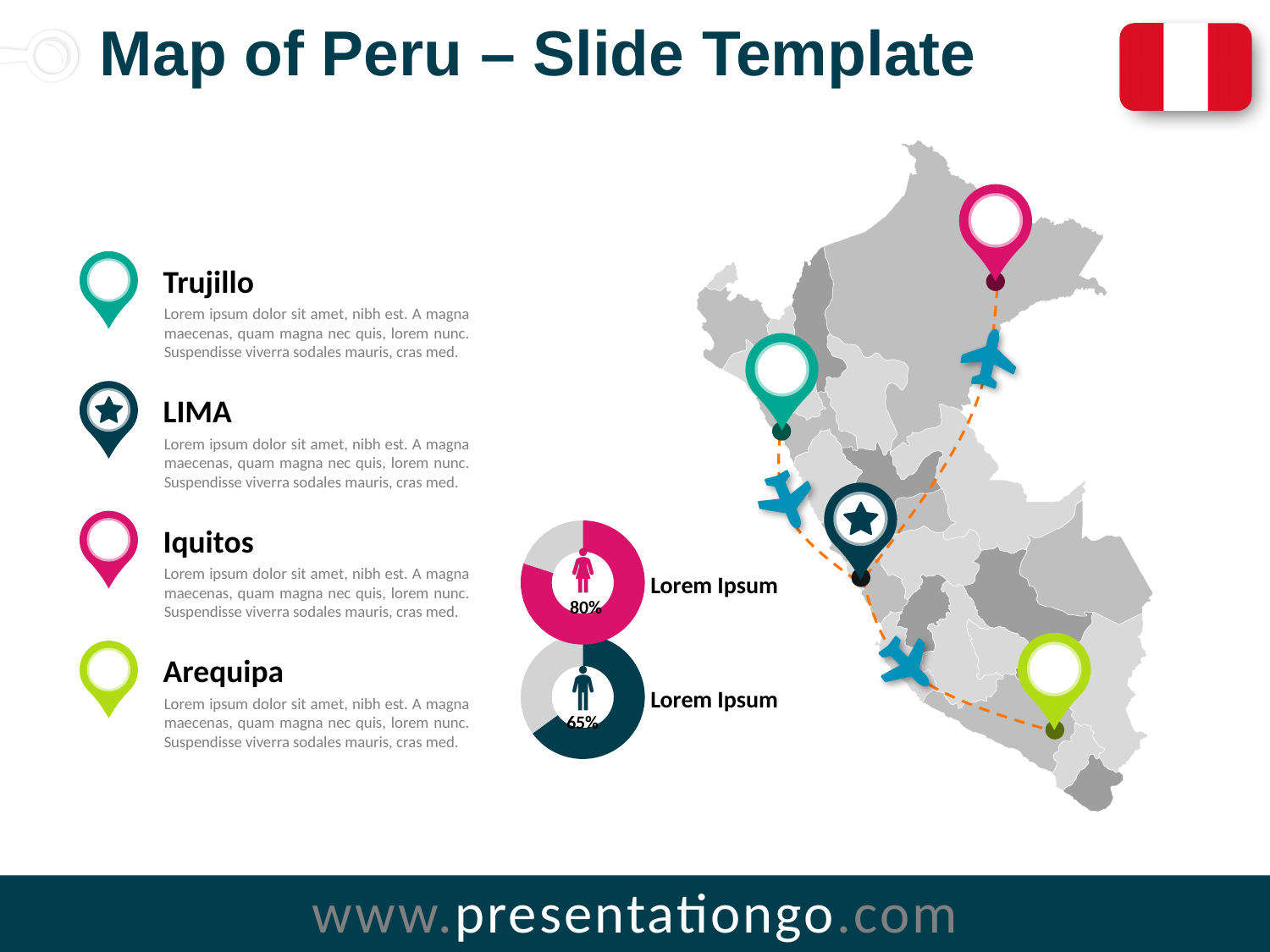
What kind of charts are shown next to the map on the slide? donut charts What value is shown on the lower donut chart (the dark teal one with the male icon)? 65% What is the difference between the value on the upper donut chart and the value on the lower donut chart? 15% What colour is the filled portion of the upper donut chart? pink Which of the two donut charts shows the larger value, the upper pink one or the lower dark teal one? the upper pink one What value is shown on the upper donut chart (the pink one with the female icon)? 80% Is the value on the lower donut chart greater or less than 50%? greater Is the value on the upper donut chart greater or less than 75%? greater How many donut charts are on the slide? 2 What label text appears to the right of each donut chart? Lorem Ipsum